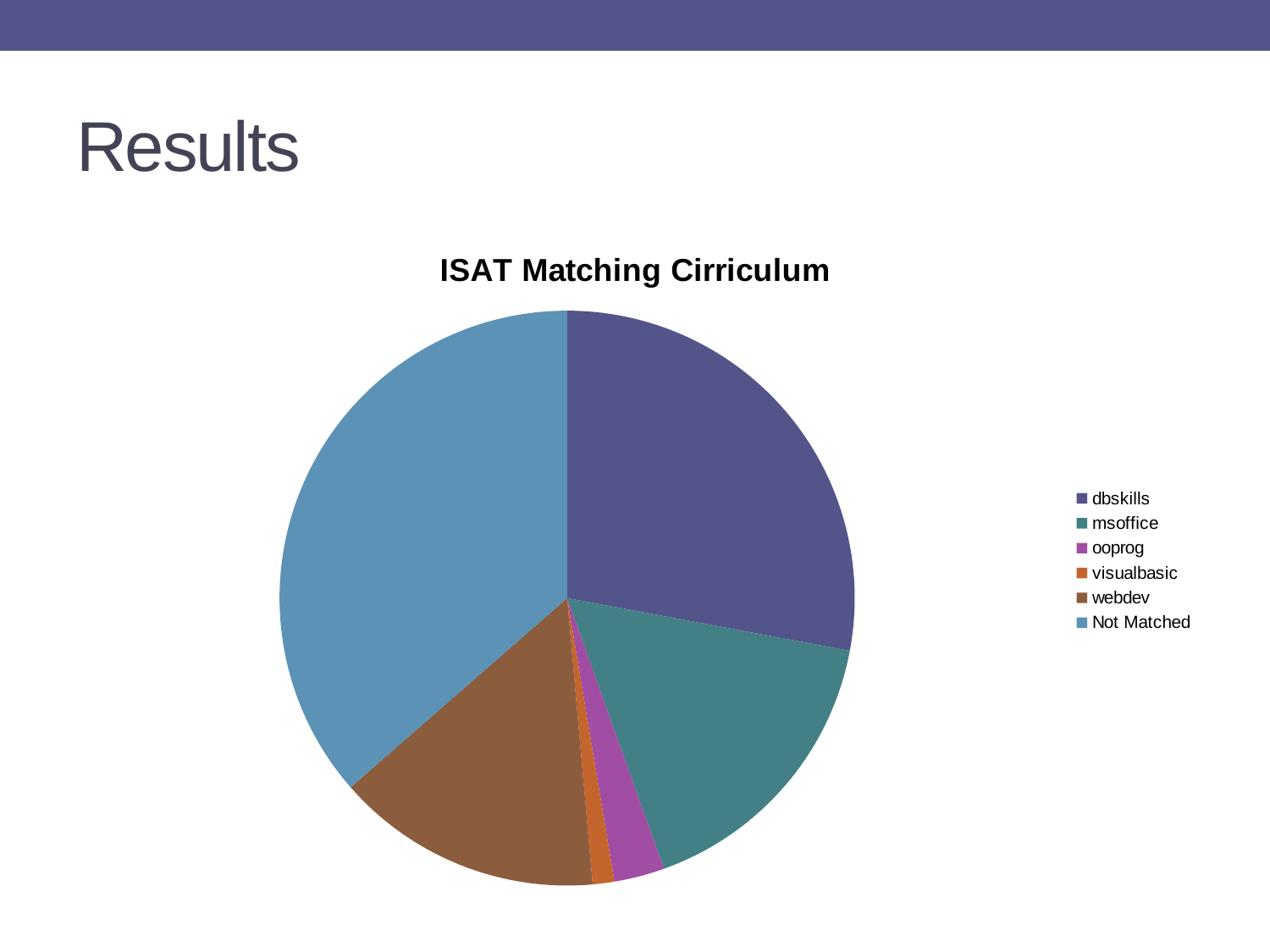
Which slice is larger, dbskills or msoffice? dbskills Which slice is larger, Not Matched or msoffice? Not Matched How many slices does the pie chart have? 6 What kind of chart is shown on the slide? pie chart Which category has the smallest slice of the pie? visualbasic Which category has the largest slice of the pie? Not Matched Which slice is larger, ooprog or visualbasic? ooprog How many entries does the chart's legend list? 6 What is the title of the chart? ISAT Matching Cirriculum Which legend entry is listed last in the chart's legend? Not Matched